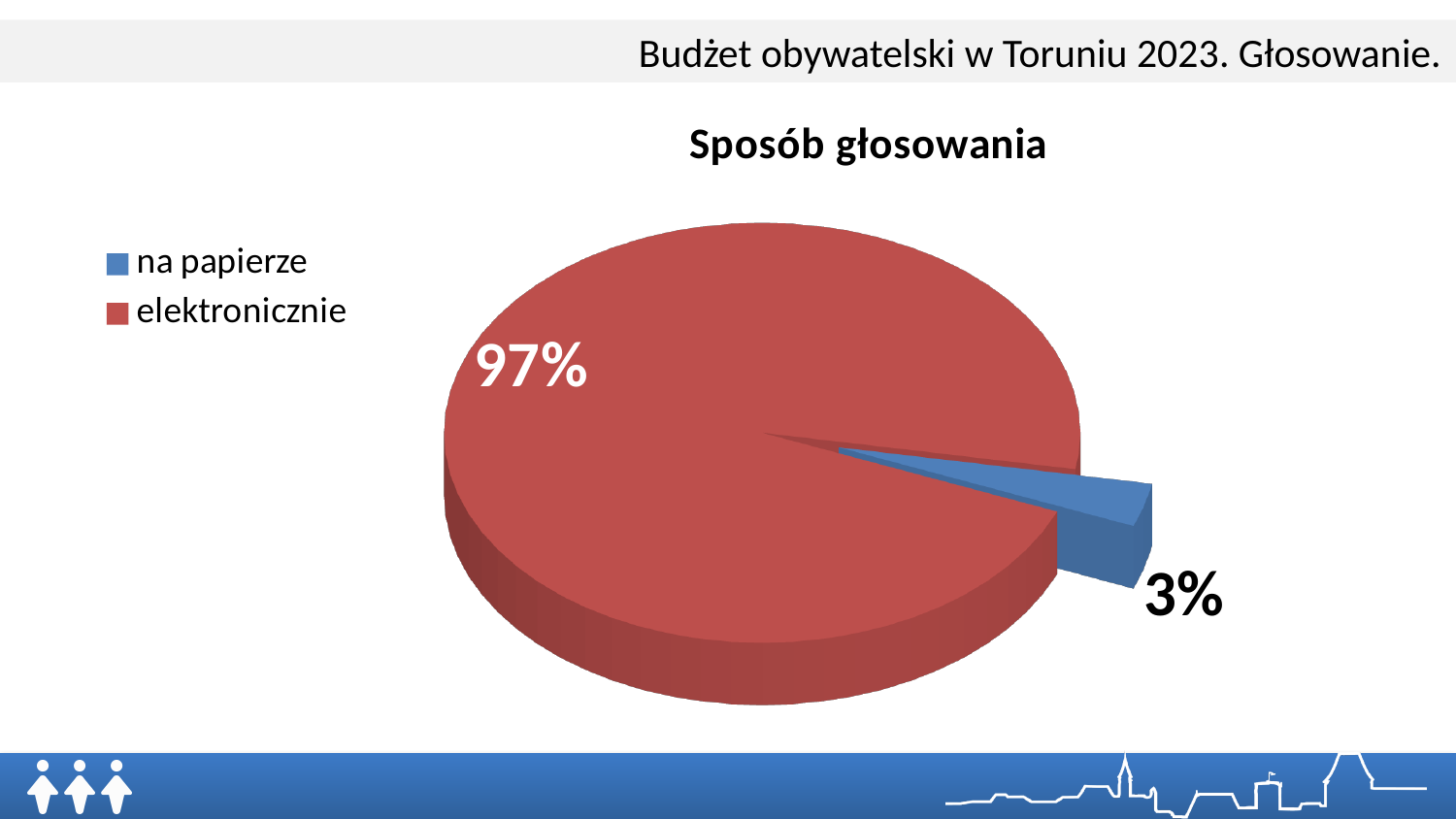
Which category has the largest slice of the pie? elektronicznie Which colour represents 'na papierze' in the legend? blue What is the title of the chart? Sposób głosowania How many categories does the pie chart show? 2 What share of the pie does 'elektronicznie' have? 97% Which category has the smallest slice of the pie? na papierze What kind of chart is shown on the slide? pie chart What is the difference in percentage points between 'elektronicznie' and 'na papierze'? 94 Which is larger, the share for 'na papierze' or for 'elektronicznie'? elektronicznie What share of the pie does 'na papierze' have? 3%